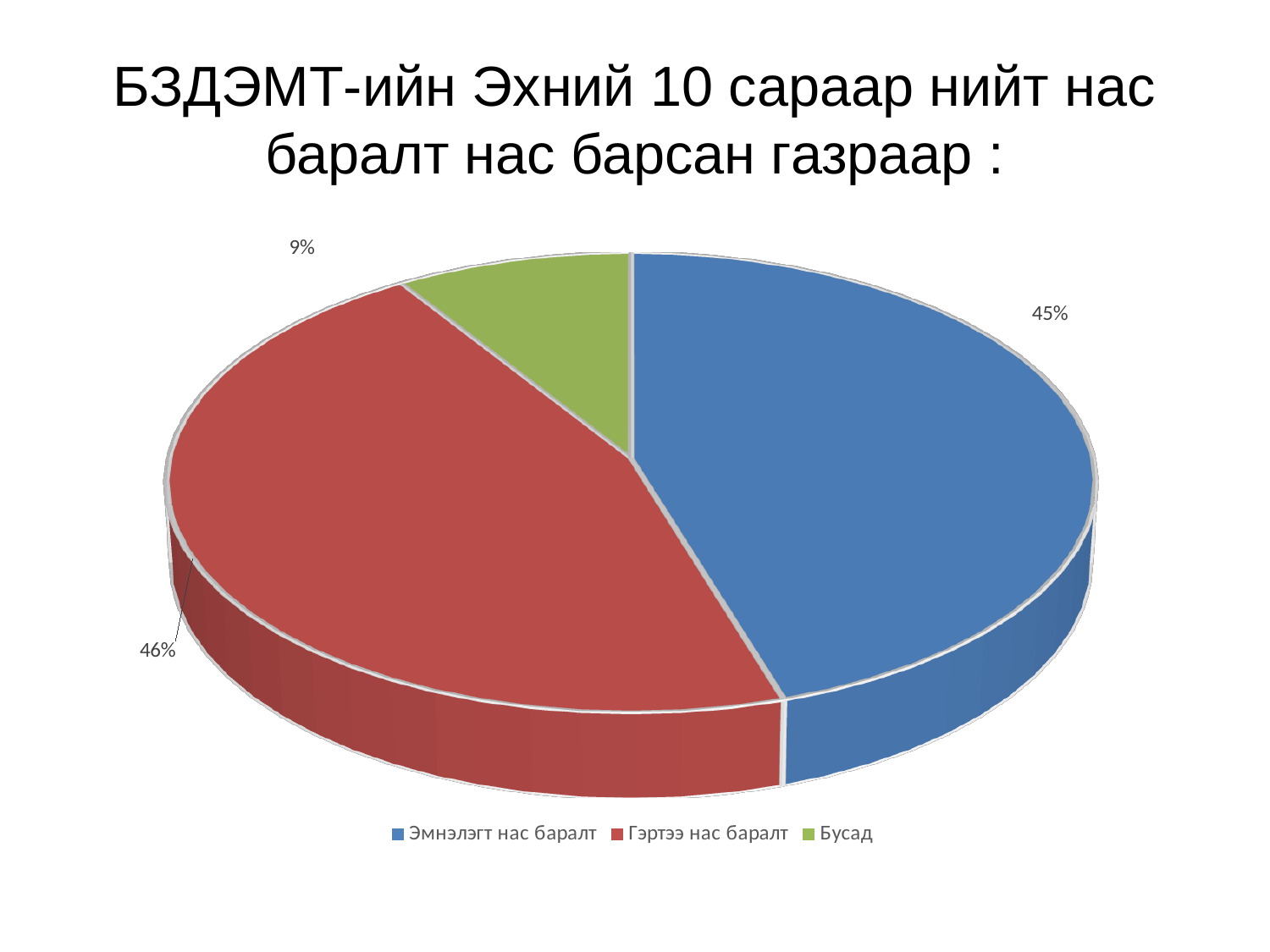
Which category has the smallest slice of the pie? Бусад How many slices does the pie chart have? 3 How many percentage points larger is the Гэртээ нас баралт slice than the Бусад slice? 37 What colour is the slice for Бусад? Green Which is larger, the slice for Гэртээ нас баралт or the slice for Бусад? Гэртээ нас баралт How many percentage points larger is the Эмнэлэгт нас баралт slice than the Бусад slice? 36 What share of the pie is labelled for Бусад? 9% How many entries does the legend list? 3 What kind of chart is shown on the slide? Pie chart What share of the pie is labelled for Гэртээ нас баралт? 46% What share of the pie is labelled for Эмнэлэгт нас баралт? 45% Which category has the largest slice of the pie according to the data labels? Гэртээ нас баралт